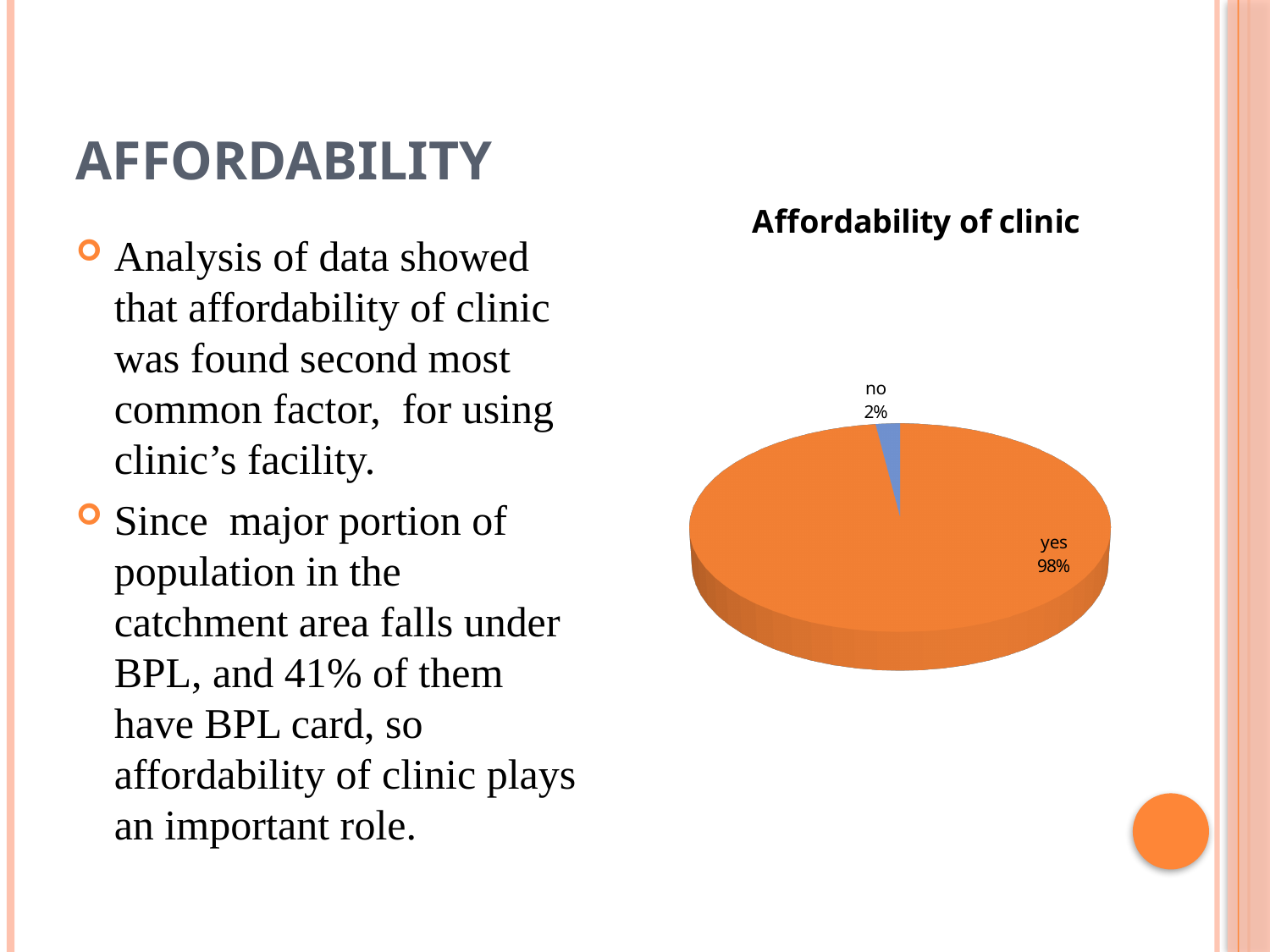
What is the difference in percentage points between the "yes" and "no" slices? 96 What is the title of the chart? Affordability of clinic Which is larger, the "yes" slice or the "no" slice? yes What colour is the "yes" slice of the pie? orange Which slice of the pie is the largest? yes Which slice of the pie is the smallest? no What percentage of the pie is labelled "yes"? 98% What type of chart is shown on the slide? pie chart What share of the pie does the "no" slice represent? 2% How many slices does the pie chart have? 2 What percentage of the pie is labelled "no"? 2%